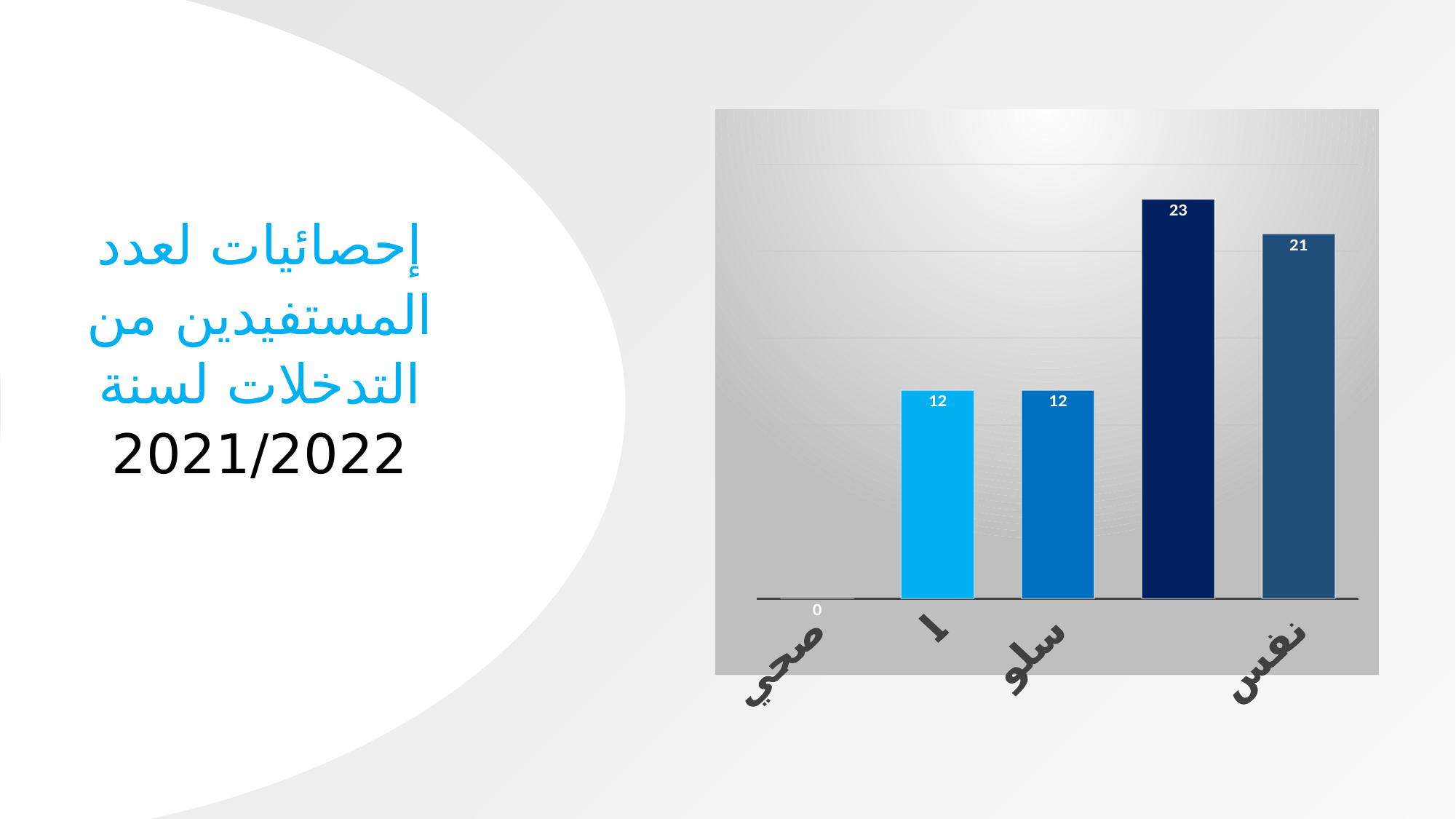
What is the value of the bar labelled نفس? 21 Which is larger, the value for نفس or the value for سلو? نفس Do the bars labelled 1 and سلو have the same value? Yes How many bars are plotted in the chart? 5 What kind of chart is shown on the slide? bar chart What is the value of the bar labelled 1? 12 What year does the slide title say the statistics are for? 2021/2022 What is the value of the bar labelled صحي? 0 Which labelled category has the lowest value in the chart? صحي What is the difference between the values for نفس and سلو? 9 What is the value of the bar labelled سلو? 12 What is the largest value plotted in the chart? 23